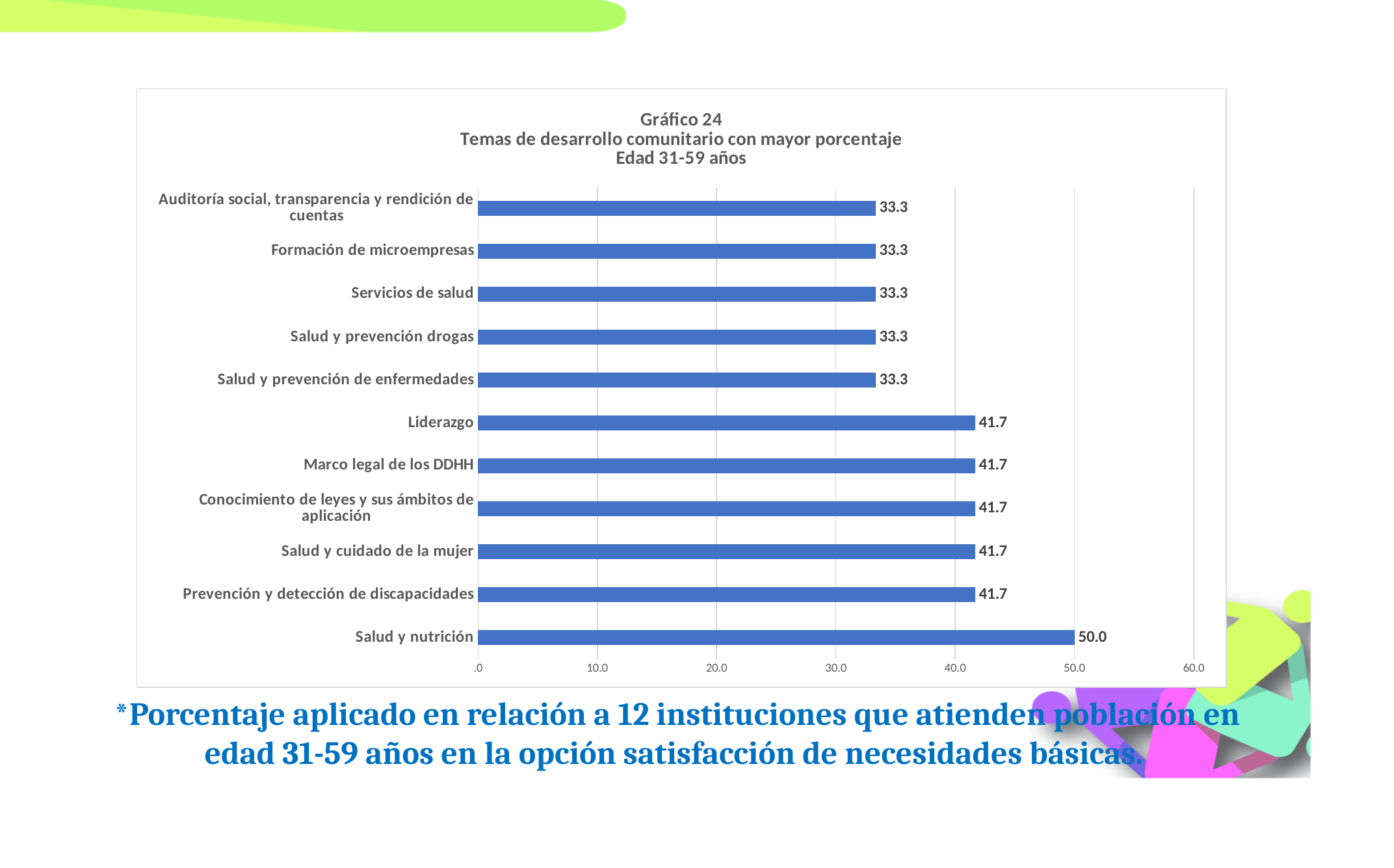
Which category has the highest value? Salud y nutrición Which is larger, the value for Prevención y detección de discapacidades or the value for Salud y prevención drogas? Prevención y detección de discapacidades What age range is named in the chart title? 31-59 años What is the value for Liderazgo? 41.7 What is the value for Servicios de salud? 33.3 Is the value for Salud y nutrición greater or less than 40.0? greater What kind of chart is shown on the slide? Bar chart What is the value for Salud y nutrición? 50.0 What is the difference between the values for Salud y cuidado de la mujer and Formación de microempresas? 8.4 How many categories are shown in the chart? 11 What is the difference between the values for Salud y nutrición and Liderazgo? 8.3 What is the value for Marco legal de los DDHH? 41.7